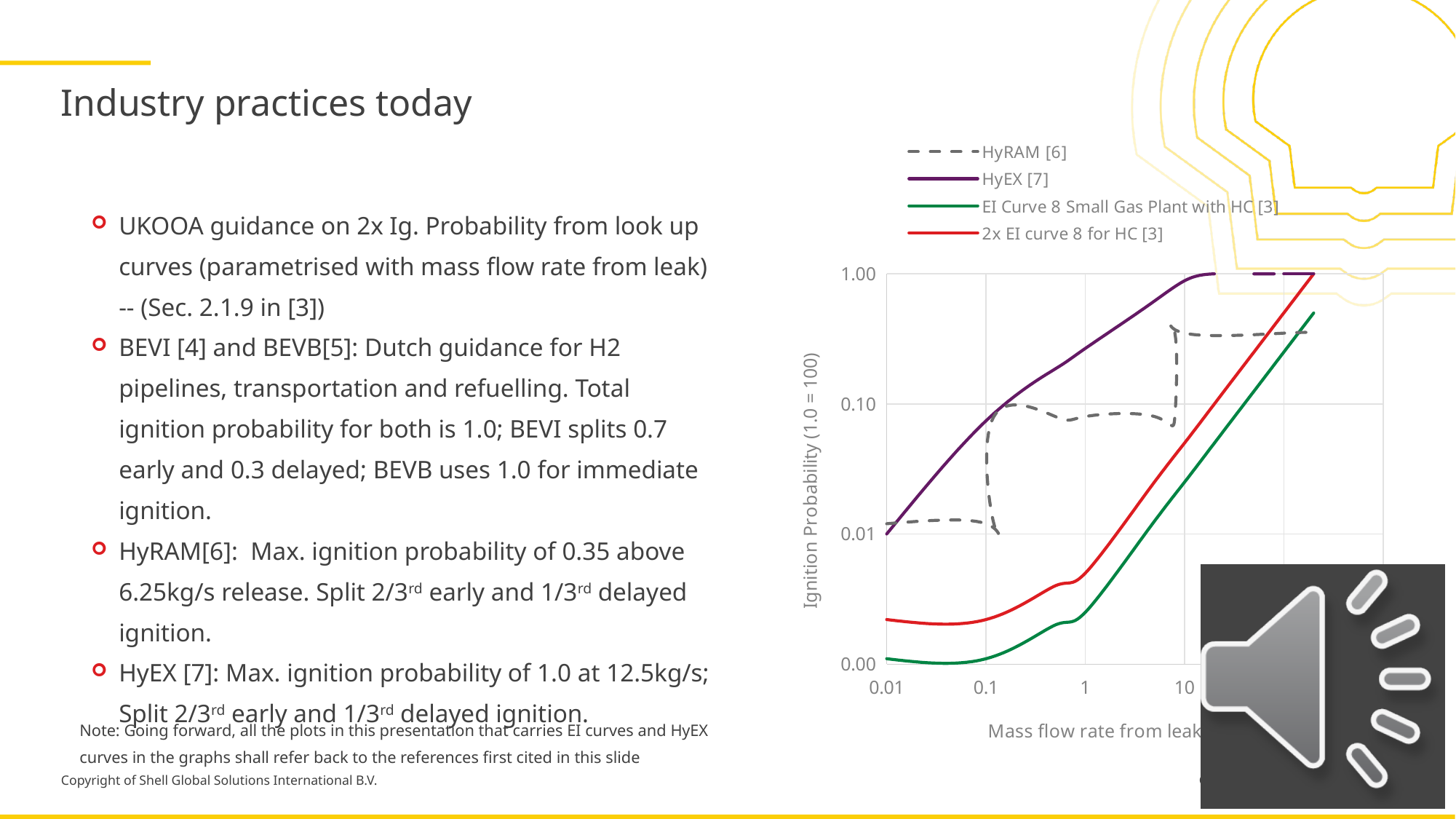
At a mass flow rate of 1, which curve is higher: 2x EI curve 8 for HC [3] or EI Curve 8 Small Gas Plant with HC [3]? 2x EI curve 8 for HC [3] Is the value of the 2x EI curve 8 for HC [3] curve at a mass flow rate of 1 greater or less than 0.01? greater Does the HyEX [7] curve rise or fall as the mass flow rate increases? Rise What is the label of the y axis of the chart? Ignition Probability (1.0 = 100) Which series has the lowest ignition probability at a mass flow rate of 1? EI Curve 8 Small Gas Plant with HC [3] Is the value of the HyEX [7] curve at a mass flow rate of 10 greater or less than 0.10? greater Is the value of the HyRAM [6] curve at a mass flow rate of 10 greater or less than 1.00? less Which series is drawn with a dashed line in the chart? HyRAM [6] At a mass flow rate of 1, which curve is higher: HyEX [7] or HyRAM [6]? HyEX [7] What kind of chart is shown on the slide? Line chart How many series does the chart legend list? 4